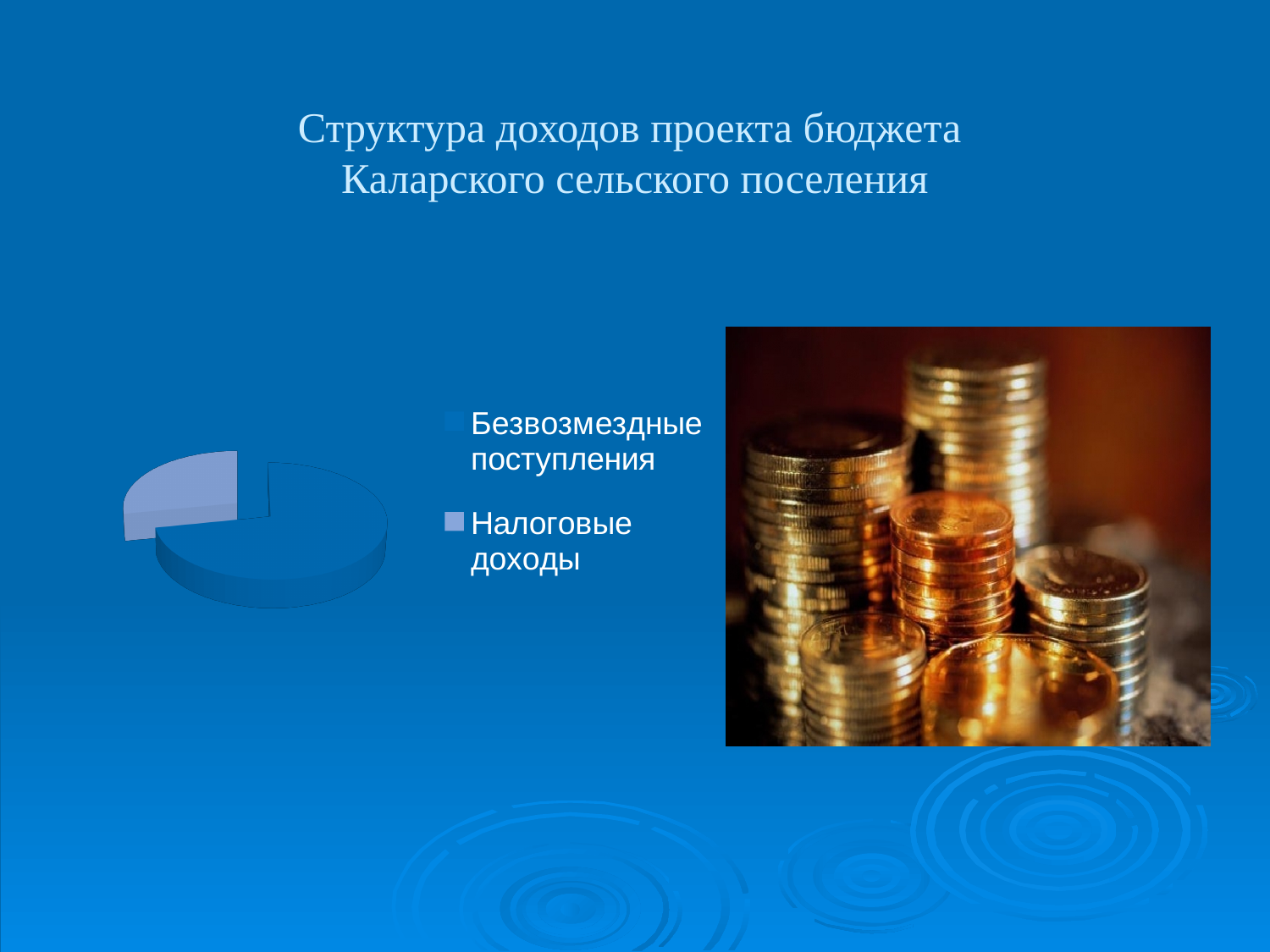
Does the slice for Безвозмездные поступления take up more or less than half of the pie? more Which legend entry is listed first in the pie chart's legend? Безвозмездные поступления Which category has the largest slice in the pie chart? Безвозмездные поступления Which slice is larger: Налоговые доходы or Безвозмездные поступления? Безвозмездные поступления How many entries does the legend of the pie chart list? 2 What is the title of the slide containing the pie chart? Структура доходов проекта бюджета Каларского сельского поселения Which category has the smallest slice in the pie chart? Налоговые доходы Does the slice for Налоговые доходы take up more or less than half of the pie? less What kind of chart is shown on the slide? pie chart How many slices does the pie chart have? 2